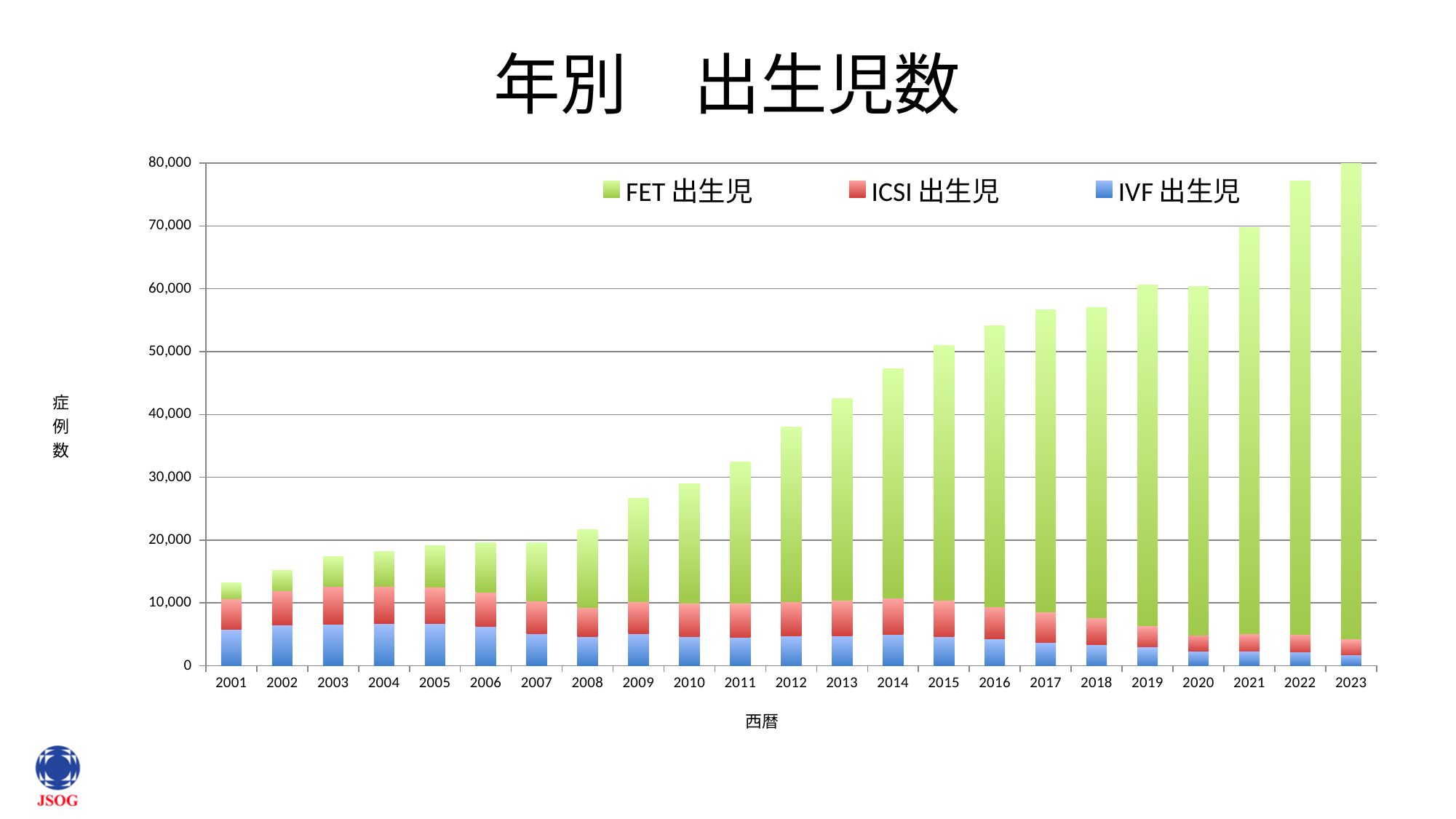
Is the total value for 2023 greater or less than 70,000? greater Which year has the highest total number of births in the chart? 2023 How many years are shown along the x axis of the chart? 23 Which year has the larger total bar, 2021 or 2022? 2022 Is the total value for 2008 greater or less than 20,000? greater How many series does the legend list? 3 What is the title of the chart on the slide? 年別 出生児数 Which legend entry is shown in green? FET 出生児 What kind of chart is shown on the slide? bar chart Is the total value for 2012 greater or less than 40,000? less Which year has the lowest total number of births in the chart? 2001 Do the total bar heights generally rise or fall from 2001 to 2023? rise